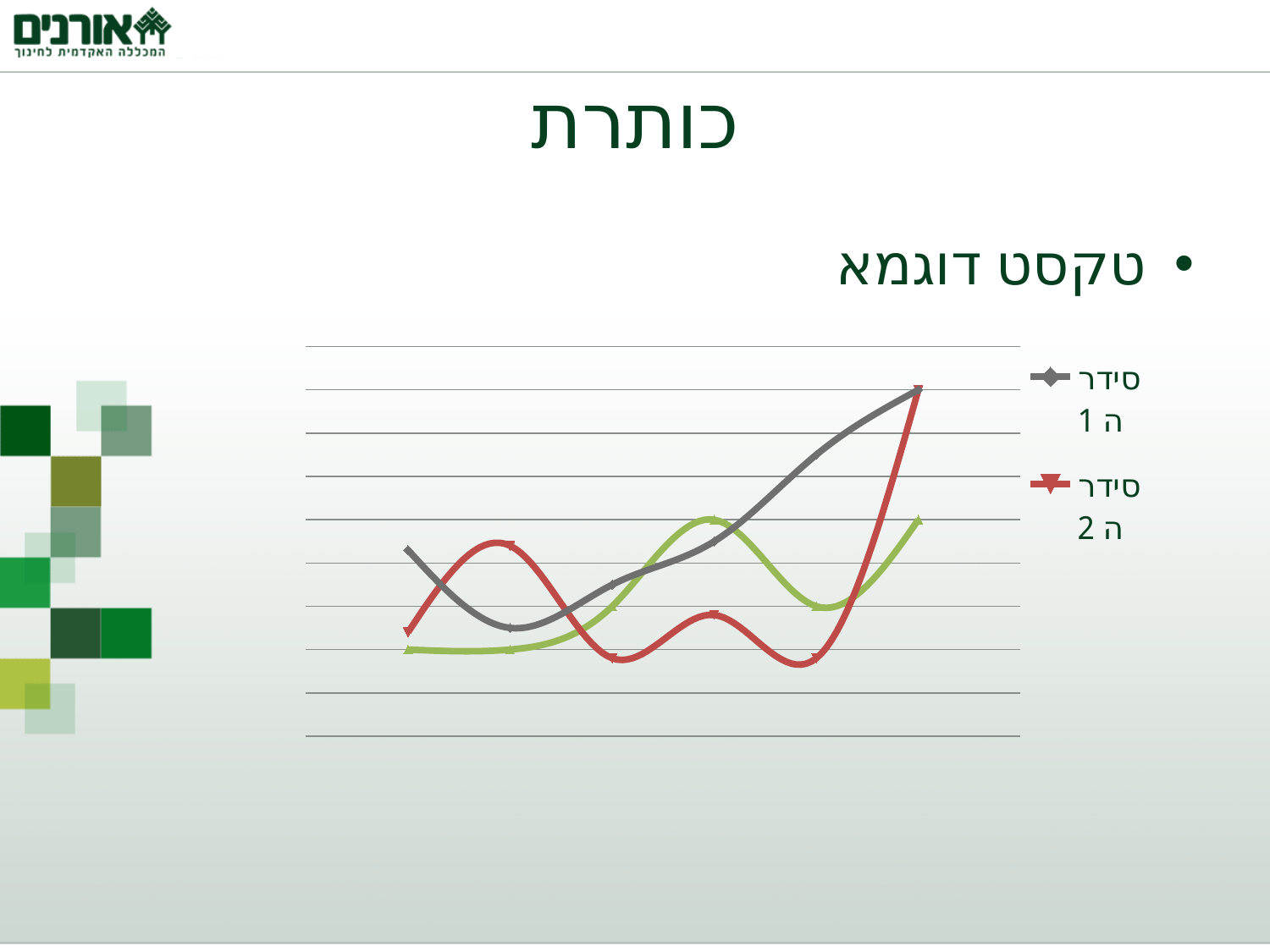
Does the gray line (סידרה 1) overall rise or fall from left to right? rise How many data points does each line on the chart have? 6 What kind of chart is shown on the slide? line chart Does the red line (סידרה 2) overall rise or fall from left to right? rise At the second point from the left, is the red line higher or lower than the gray line? higher What colour is the line for סידרה 1 in the legend? gray What colour is the line for סידרה 2 in the legend? red Which line is lowest at the first (leftmost) point: gray, red or green? green At the last (rightmost) point, is the green line higher or lower than the gray line? lower How many lines are plotted on the chart? 3 How many series does the chart's legend list? 2 Which line is highest at the first (leftmost) point: gray, red or green? gray